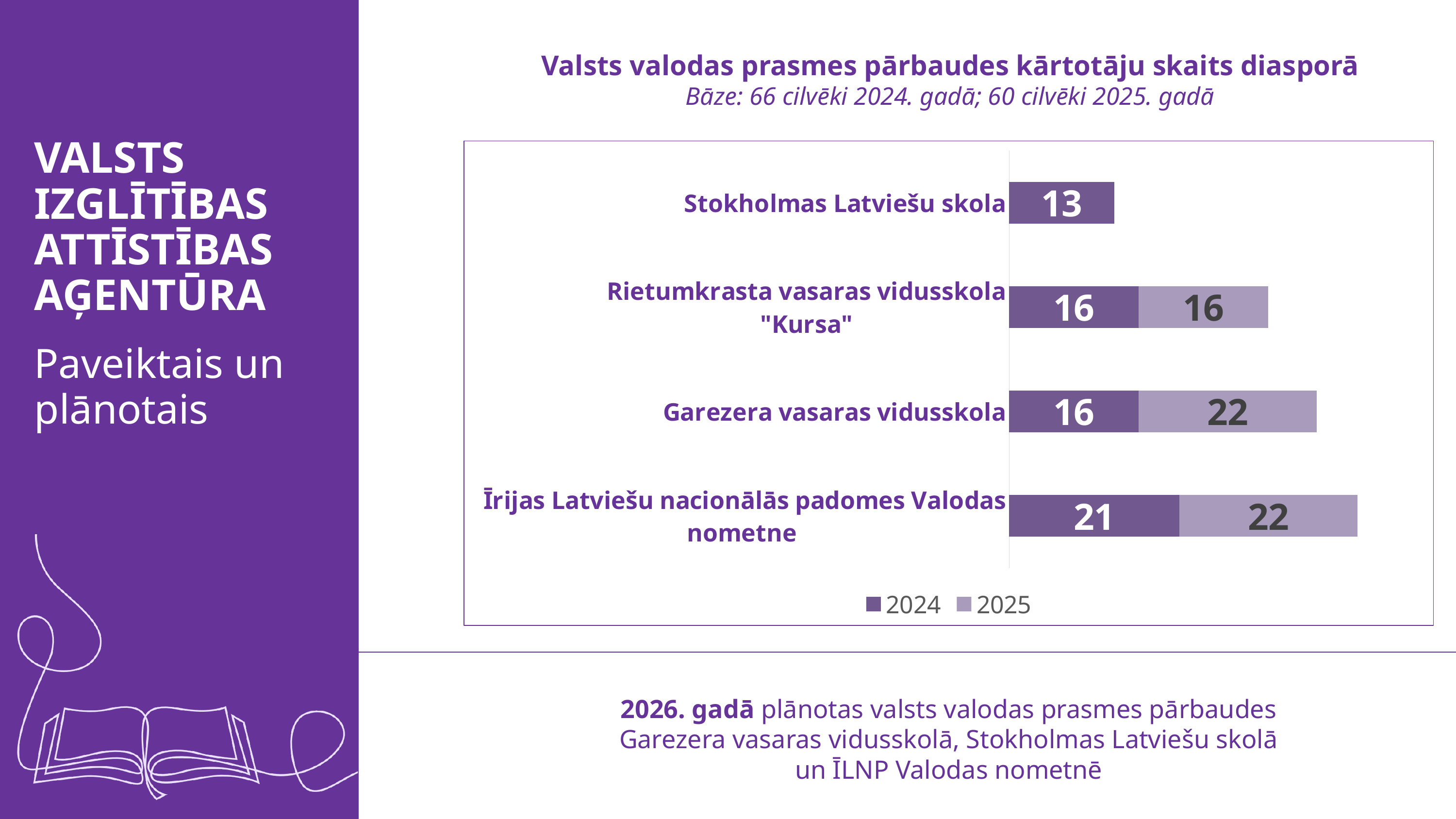
Which category has the highest 2024 value? Īrijas Latviešu nacionālās padomes Valodas nometne Which category has the lowest 2024 value? Stokholmas Latviešu skola What is the 2024 value for Stokholmas Latviešu skola? 13 How many categories are shown in the chart? 4 How many series does the legend list? 2 What is the 2025 value for Rietumkrasta vasaras vidusskola "Kursa"? 16 What is the 2024 value for Īrijas Latviešu nacionālās padomes Valodas nometne? 21 What is the total of the stacked bar for Rietumkrasta vasaras vidusskola "Kursa"? 32 Which is larger: the 2024 value for Garezera vasaras vidusskola or the 2024 value for Īrijas Latviešu nacionālās padomes Valodas nometne? Īrijas Latviešu nacionālās padomes Valodas nometne What is the total of the stacked bar for Īrijas Latviešu nacionālās padomes Valodas nometne? 43 What is the 2025 value for Garezera vasaras vidusskola? 22 What is the difference between the 2025 and 2024 values for Garezera vasaras vidusskola? 6